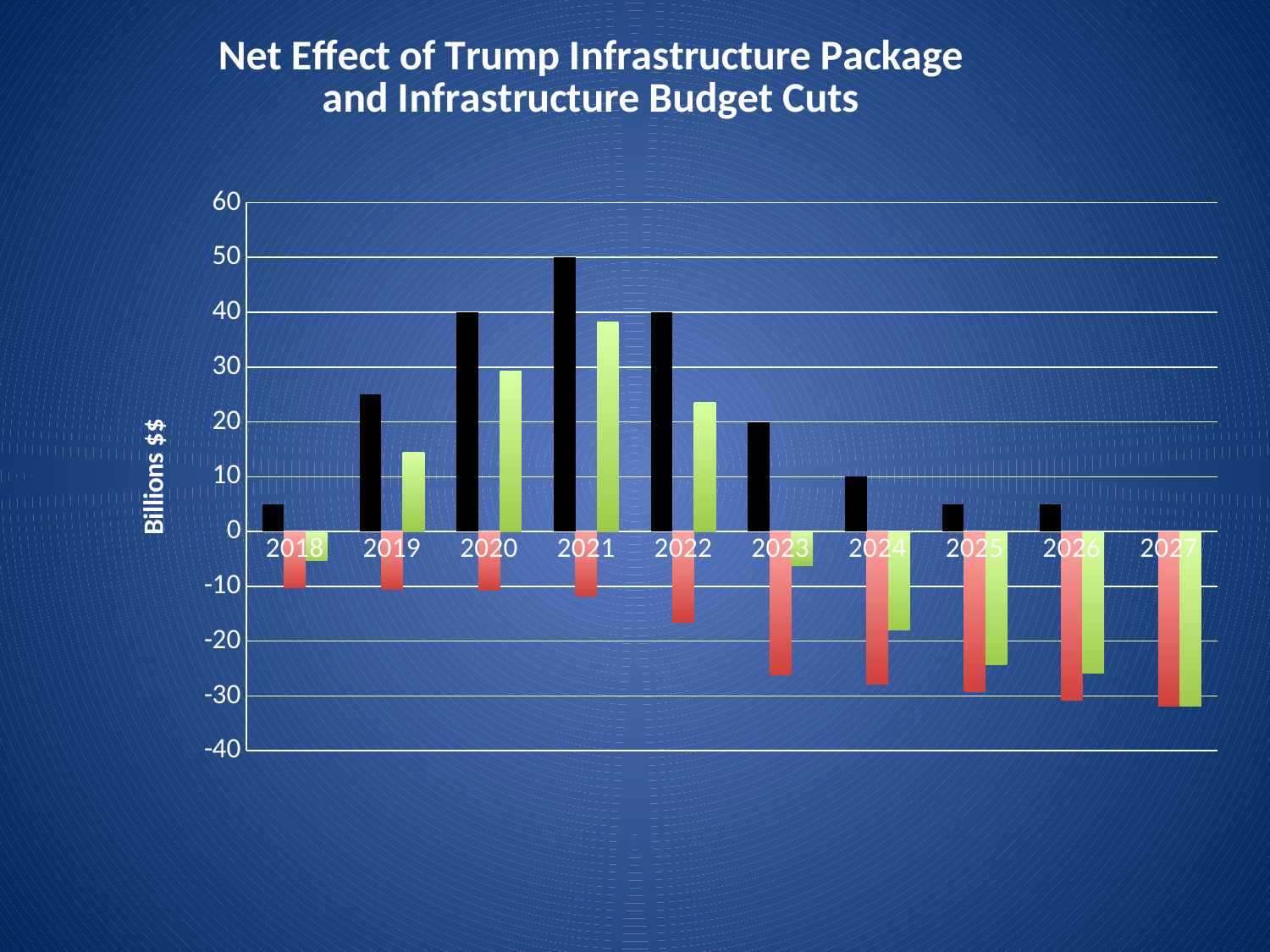
What kind of chart is shown on the slide? bar chart What is the value of the black bar for 2021? 50 Do the black bars rise or fall from 2021 to 2026? fall Which is larger, the green bar for 2020 or the green bar for 2021? 2021 What is the label on the vertical axis? Billions $$ In which year is the black bar the highest? 2021 Is the green bar for 2021 greater or less than 30? greater What is the value of the black bar for 2024? 10 What is the title of the chart? Net Effect of Trump Infrastructure Package and Infrastructure Budget Cuts What is the value of the black bar for 2020? 40 How many years are shown along the x axis? 10 Is the red bar for 2027 greater or less than -30? less